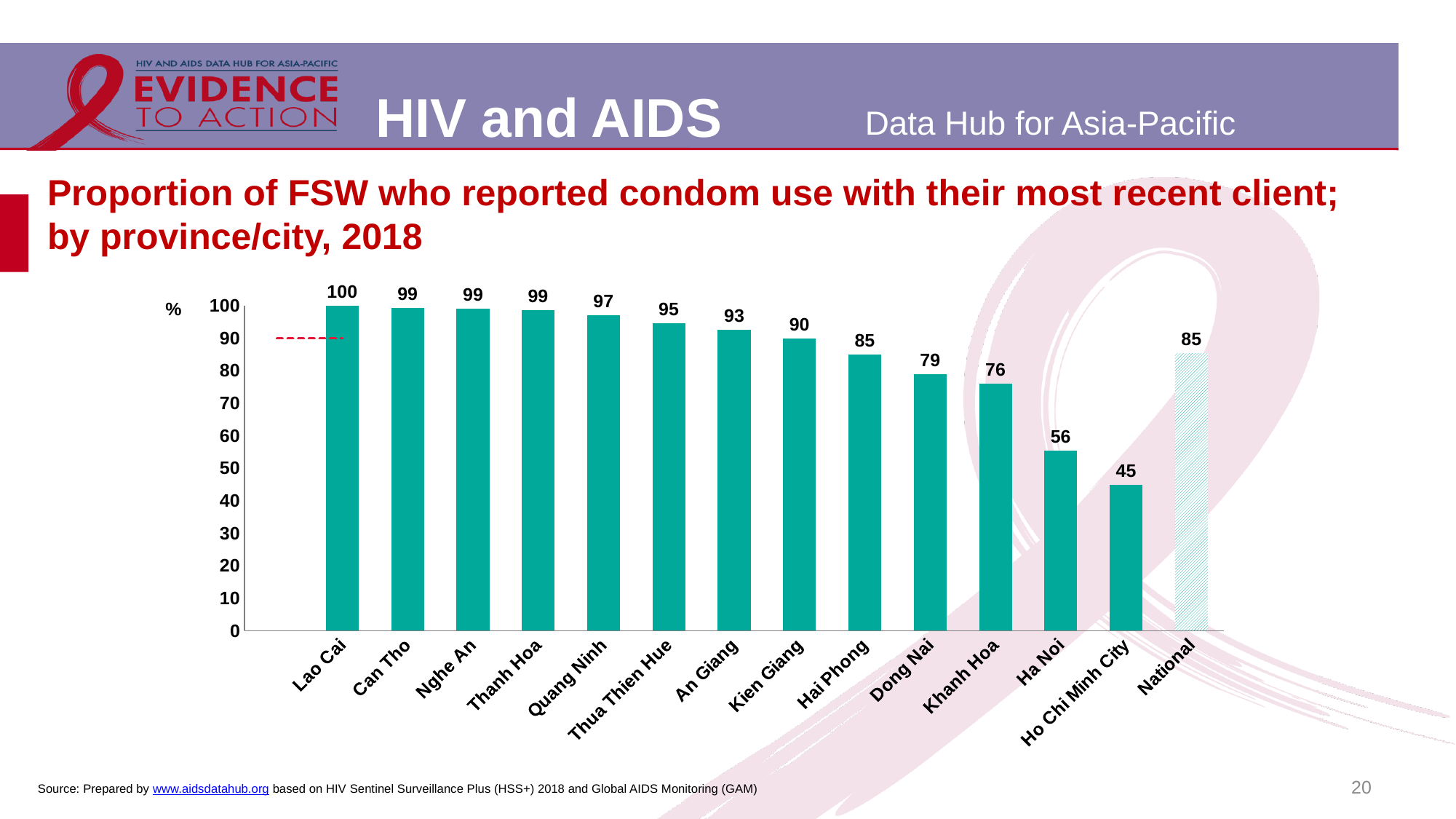
What is the unit shown on the y axis of the chart? % What is the value for Ho Chi Minh City? 45 Which province/city has the lowest value? Ho Chi Minh City How many bars are shown in the chart, including National? 14 Do the values for the provinces/cities rise or fall from left to right along the x axis? Fall What kind of chart is shown on the slide? Bar chart What is the difference between the values for Ha Noi and Ho Chi Minh City? 11 Which is larger, the value for Dong Nai or the value for Kien Giang? Kien Giang What is the National value? 85 What is the value for Lao Cai? 100 What is the value for Khanh Hoa? 76 Which province/city has the highest value? Lao Cai